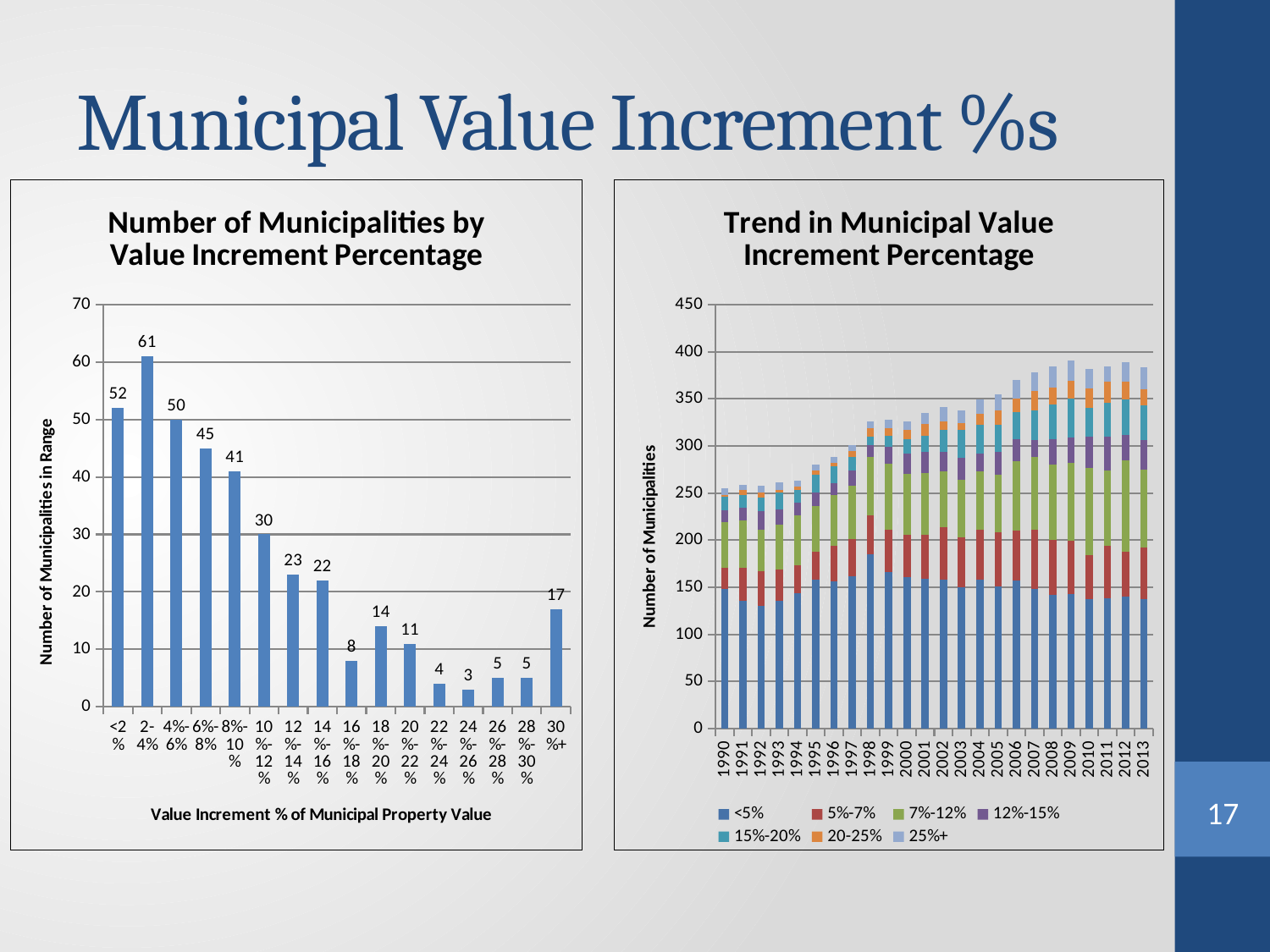
In the chart titled 'Number of Municipalities by Value Increment Percentage', what is the difference between the <2% and 4%-6% values? 2 In the chart titled 'Trend in Municipal Value Increment Percentage', how many years are shown on the x axis? 24 In the chart titled 'Number of Municipalities by Value Increment Percentage', which is larger: the value for 16%-18% or the value for 18%-20%? 18%-20% What type of chart is the left chart, 'Number of Municipalities by Value Increment Percentage'? Bar chart In the chart titled 'Number of Municipalities by Value Increment Percentage', how many value increment categories are shown on the x axis? 16 In the chart titled 'Number of Municipalities by Value Increment Percentage', how many municipalities are in the 2-4% range? 61 In the chart titled 'Number of Municipalities by Value Increment Percentage', which value increment range has the highest number of municipalities? 2-4% In the chart titled 'Trend in Municipal Value Increment Percentage', what is the label of the y axis? Number of Municipalities In the chart titled 'Trend in Municipal Value Increment Percentage', is the total stacked value for 2013 greater or less than 350? greater In the chart titled 'Number of Municipalities by Value Increment Percentage', what is the value for the 30%+ category? 17 In the chart titled 'Number of Municipalities by Value Increment Percentage', which value increment range has the lowest number of municipalities? 24%-26% In the chart titled 'Trend in Municipal Value Increment Percentage', how many series does the legend list? 7